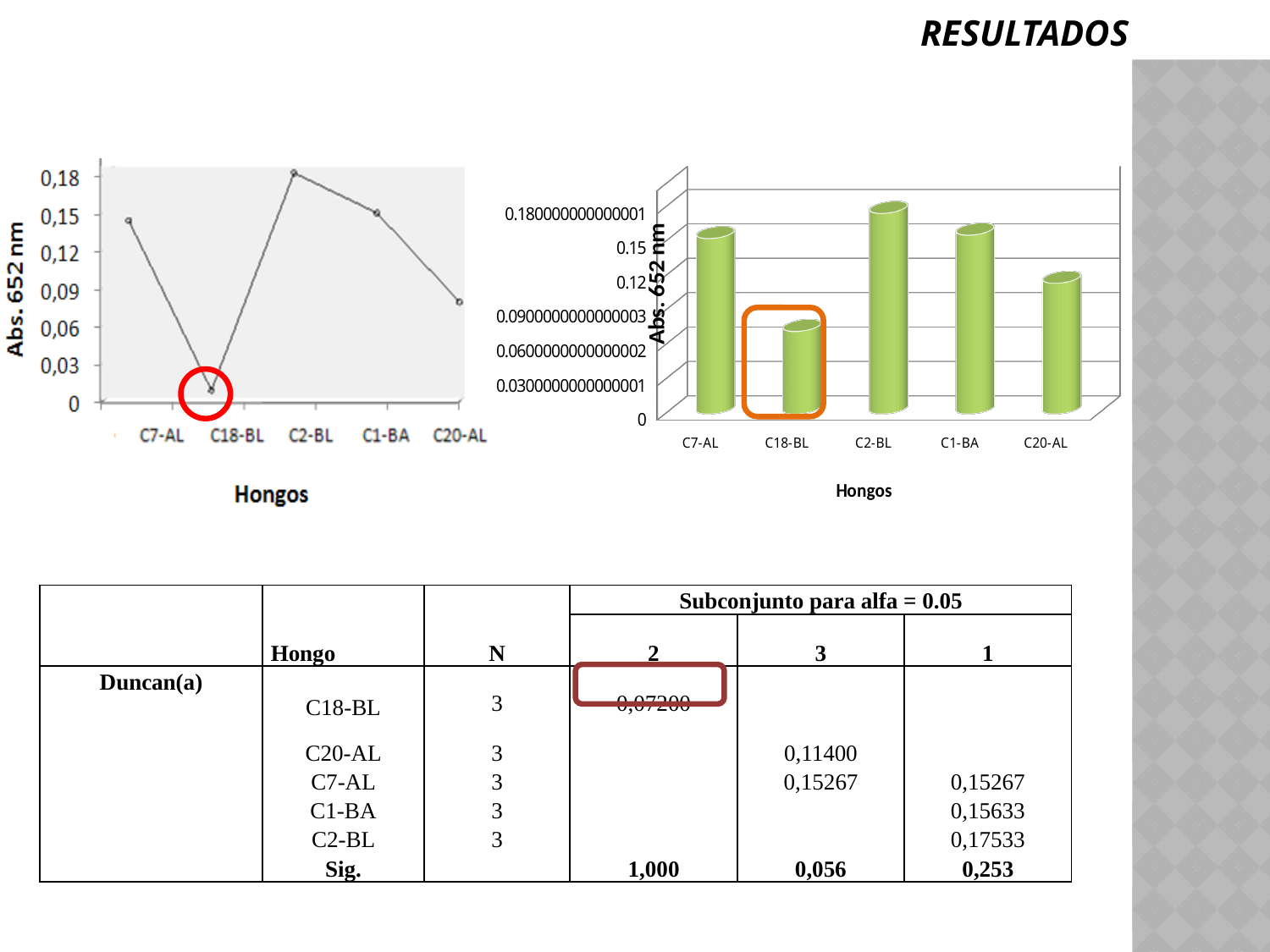
In the left line chart, is the value for C18-BL greater or less than 0,03? less In the right bar chart, which category has the shortest bar? C18-BL In the left line chart, which category has the highest value? C2-BL What kind of chart is the chart on the right of the slide? bar chart What is the x-axis title of the right bar chart? Hongos In the right bar chart, which category has the tallest bar? C2-BL In the left line chart, which category has the lowest value? C18-BL In the left line chart, do the values rise or fall from C2-BL to C20-AL? fall In the right bar chart, is the value for C20-AL greater or less than 0.09? greater In the left line chart, which is larger, the value for C7-AL or the value for C20-AL? C7-AL What kind of chart is the chart on the left of the slide? line chart How many categories are shown on the x axis of the left line chart? 5